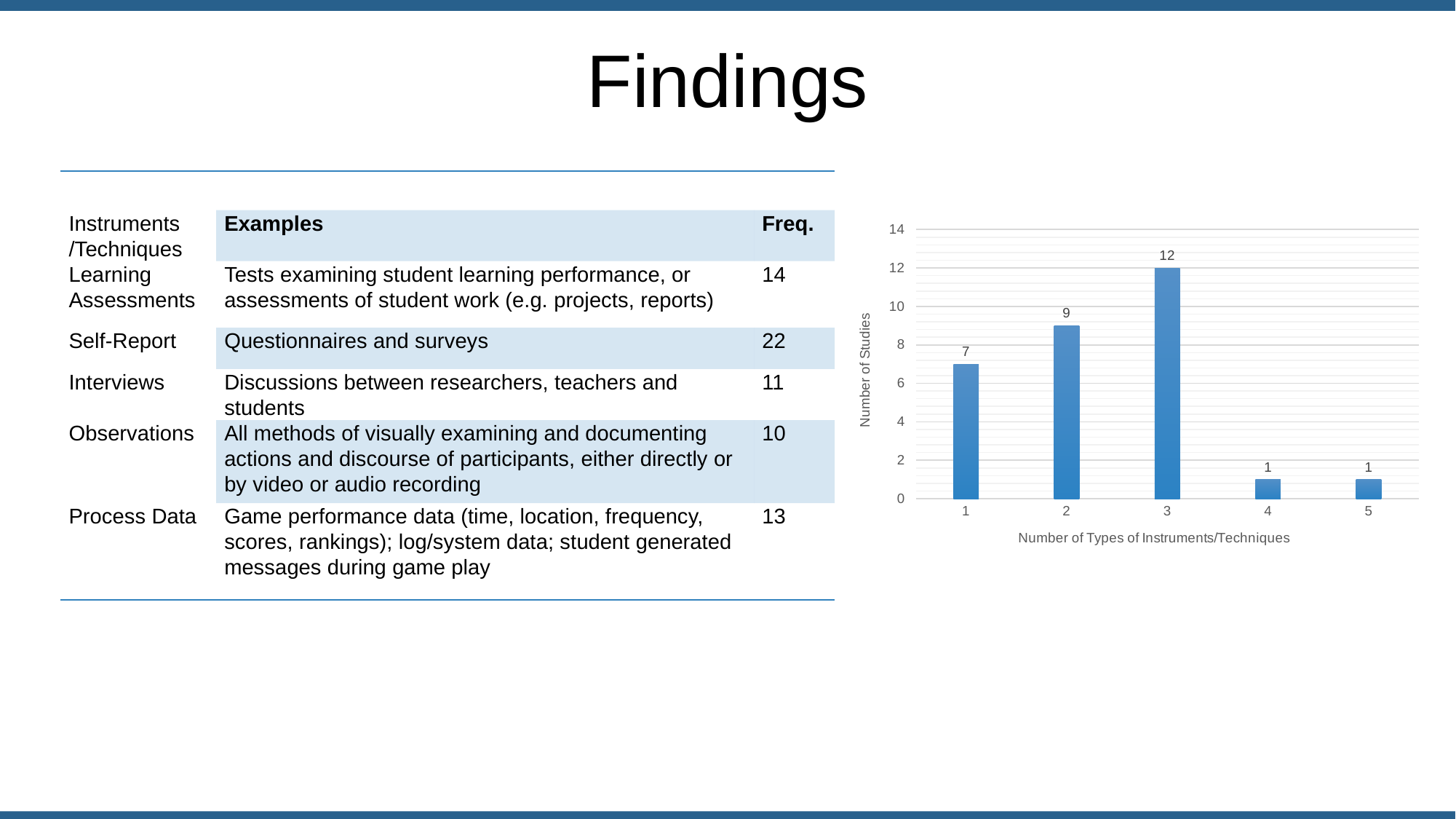
What is the difference in number of studies between 3 types and 2 types of instruments/techniques? 3 What is the number of studies for 1 type of instruments/techniques? 7 How many categories are shown on the x axis of the chart? 5 Which number of types of instruments/techniques has the highest number of studies? 3 What is the number of studies for 3 types of instruments/techniques? 12 What is the label of the x axis of the chart? Number of Types of Instruments/Techniques What kind of chart is shown on the slide? bar chart What is the number of studies for 2 types of instruments/techniques? 9 Is the number of studies for 3 types of instruments/techniques greater or less than 10? greater Which has more studies: 1 type or 2 types of instruments/techniques? 2 types What is the label of the y axis of the chart? Number of Studies What is the difference in number of studies between 1 type and 4 types of instruments/techniques? 6